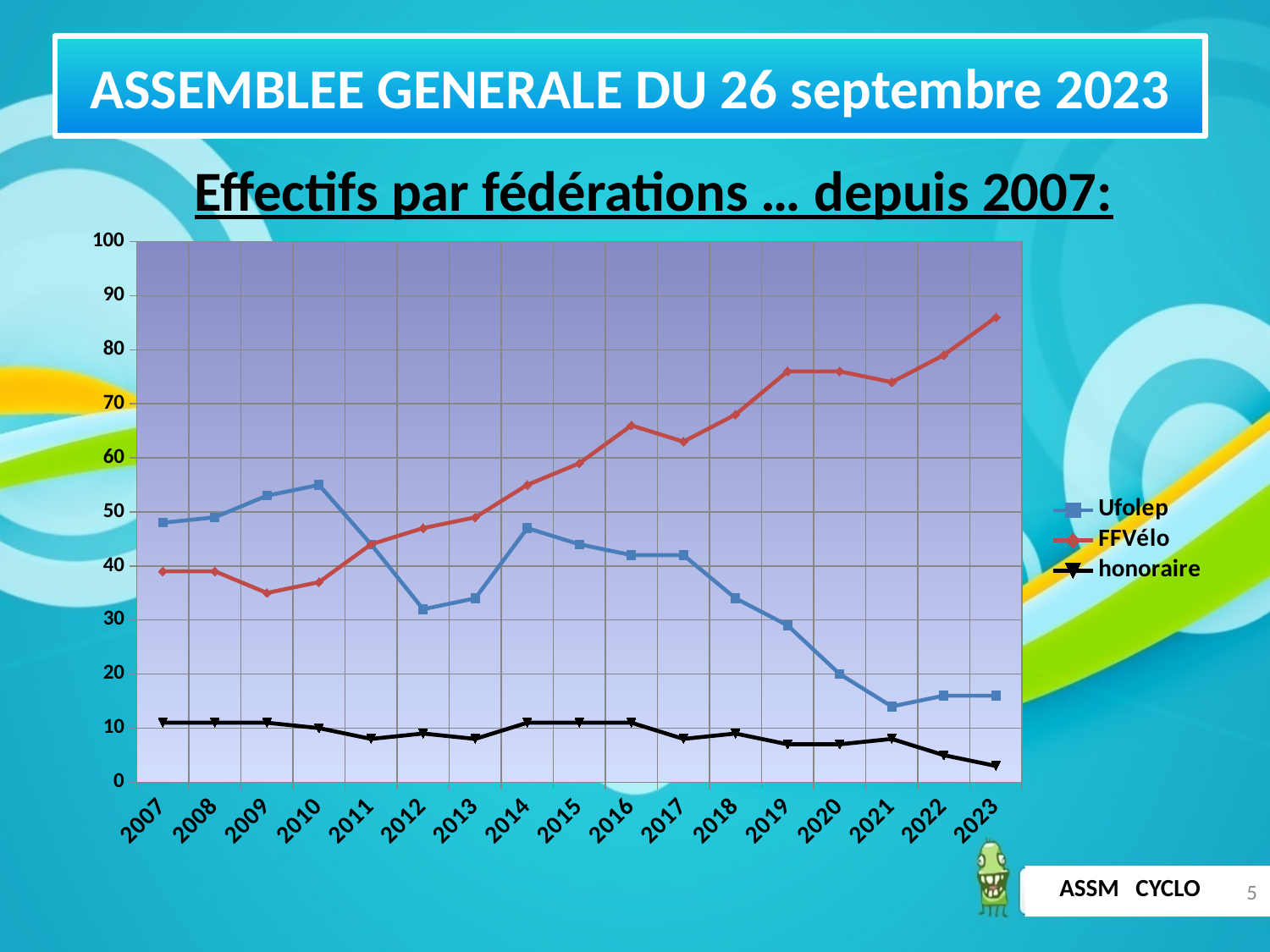
In which year does the FFVélo series reach its highest value? 2023 In 2007, which is larger, the Ufolep value or the FFVélo value? Ufolep How many years are plotted along the x axis? 17 Does the Ufolep series rise or fall overall from 2010 to 2021? fall Is the Ufolep value for 2021 greater or less than 20? less How many series does the legend list? 3 Does the FFVélo series rise or fall overall from 2007 to 2023? rise Is the FFVélo value for 2023 greater or less than 80? greater What is the title of the chart? Effectifs par fédérations … depuis 2007: What kind of chart is shown on the slide? line chart Which series is drawn in red? FFVélo Is the honoraire value for 2023 greater or less than 10? less